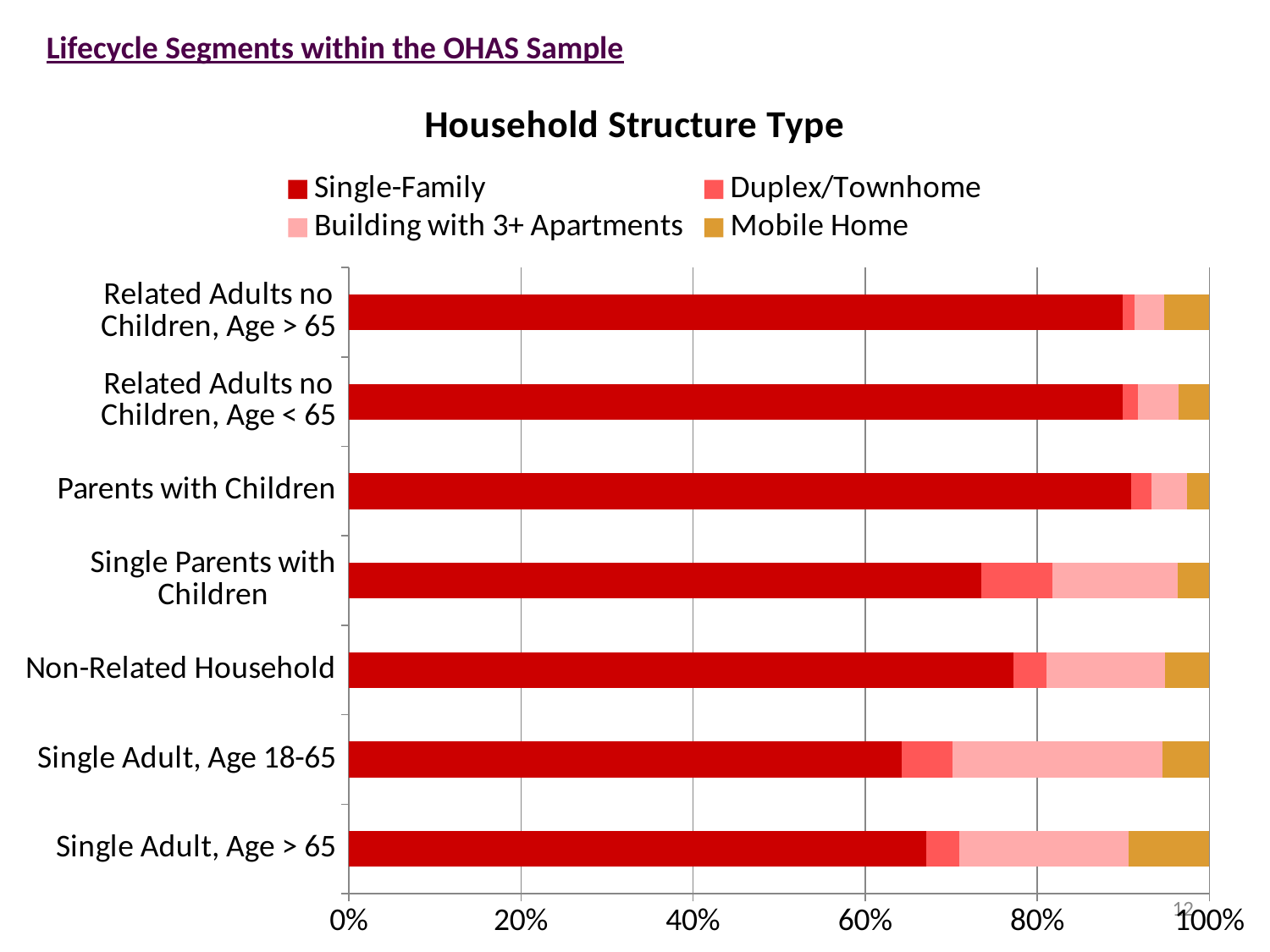
What is the title of the chart? Household Structure Type Which category has the largest Mobile Home segment? Single Adult, Age > 65 Which legend entry is shown in the gold/mustard colour? Mobile Home What do the segments of each stacked bar add up to? 100% How many series does the legend list? 4 Which has the larger Single-Family share: Parents with Children or Single Adult, Age > 65? Parents with Children Is the Single-Family share for Non-Related Household greater or less than 60%? greater Is the Single-Family share for Single Adult, Age 18-65 greater or less than 80%? less What type of chart is shown on the slide? Stacked bar chart Which category has the largest Building with 3+ Apartments segment? Single Adult, Age 18-65 How many household lifecycle segments (categories) are plotted on the chart? 7 Is the Single-Family share for Parents with Children greater or less than 80%? greater